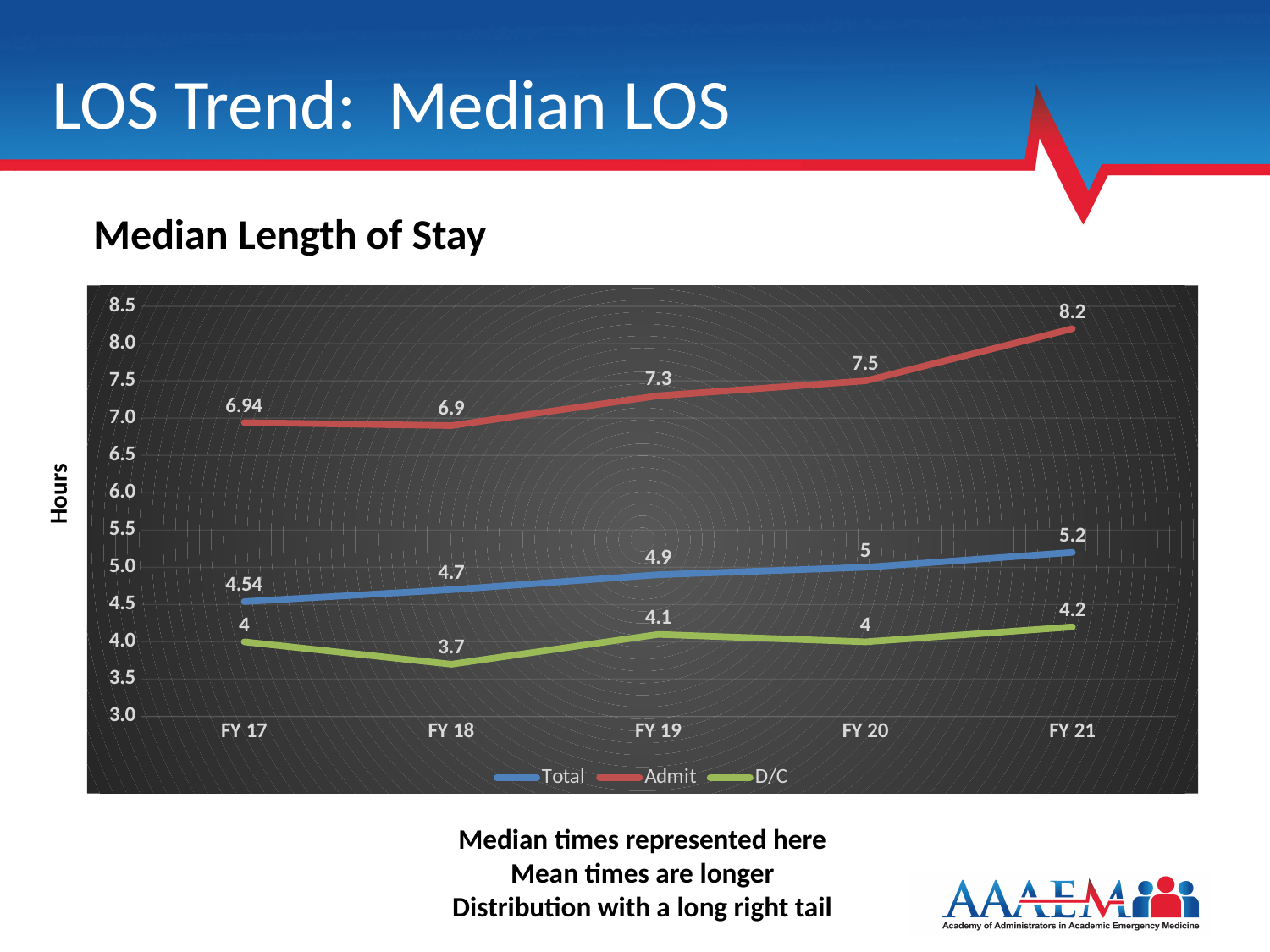
In which fiscal year is the Admit median length of stay highest? FY 21 In which fiscal year is the D/C median length of stay lowest? FY 18 What is the D/C median length of stay in FY 18? 3.7 What is the Admit median length of stay in FY 21? 8.2 How many series does the legend list? 3 Is the Admit median length of stay in FY 18 greater or less than 7.0? less Does the Total median length of stay rise or fall from FY 17 to FY 21? rise What kind of chart is shown on the slide? line chart What is the difference between the Admit and Total median length of stay in FY 20? 2.5 How many fiscal years are shown on the x axis? 5 Which is larger in FY 19: the Total median LOS or the D/C median LOS? Total What is the Total median length of stay in FY 17? 4.54